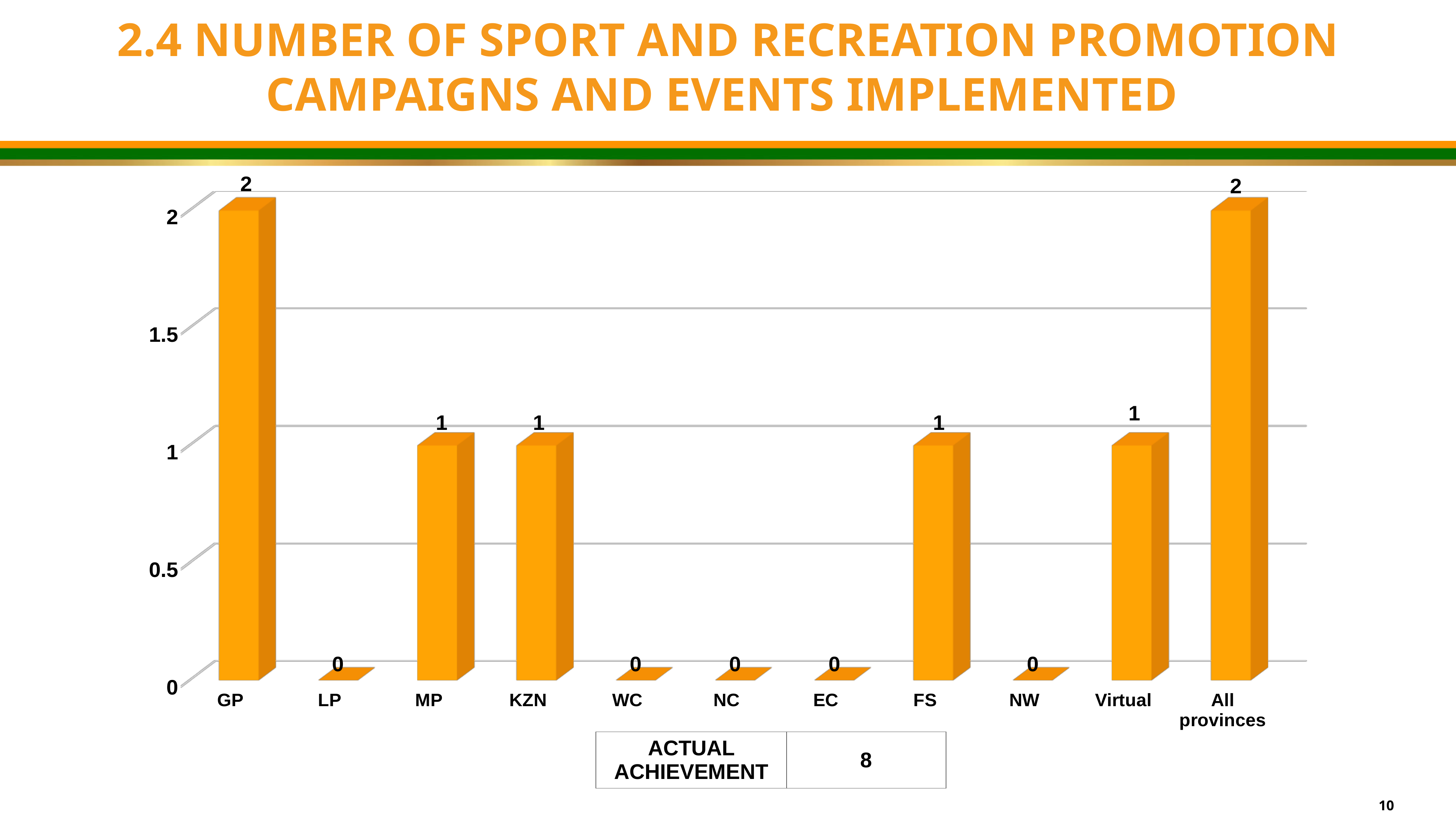
What is the difference between the values for GP and FS? 1 What is the value for KZN? 1 How many categories have a value of 0? 5 What is the value for GP? 2 What kind of chart is shown on the slide? bar chart What is the value for NW? 0 How many categories are shown on the x axis? 11 What colour are the bars in the chart? orange What is the value for Virtual? 1 Which categories have the highest value? GP and All provinces What is the actual achievement shown in the table below the chart? 8 Which is larger, the value for MP or the value for WC? MP